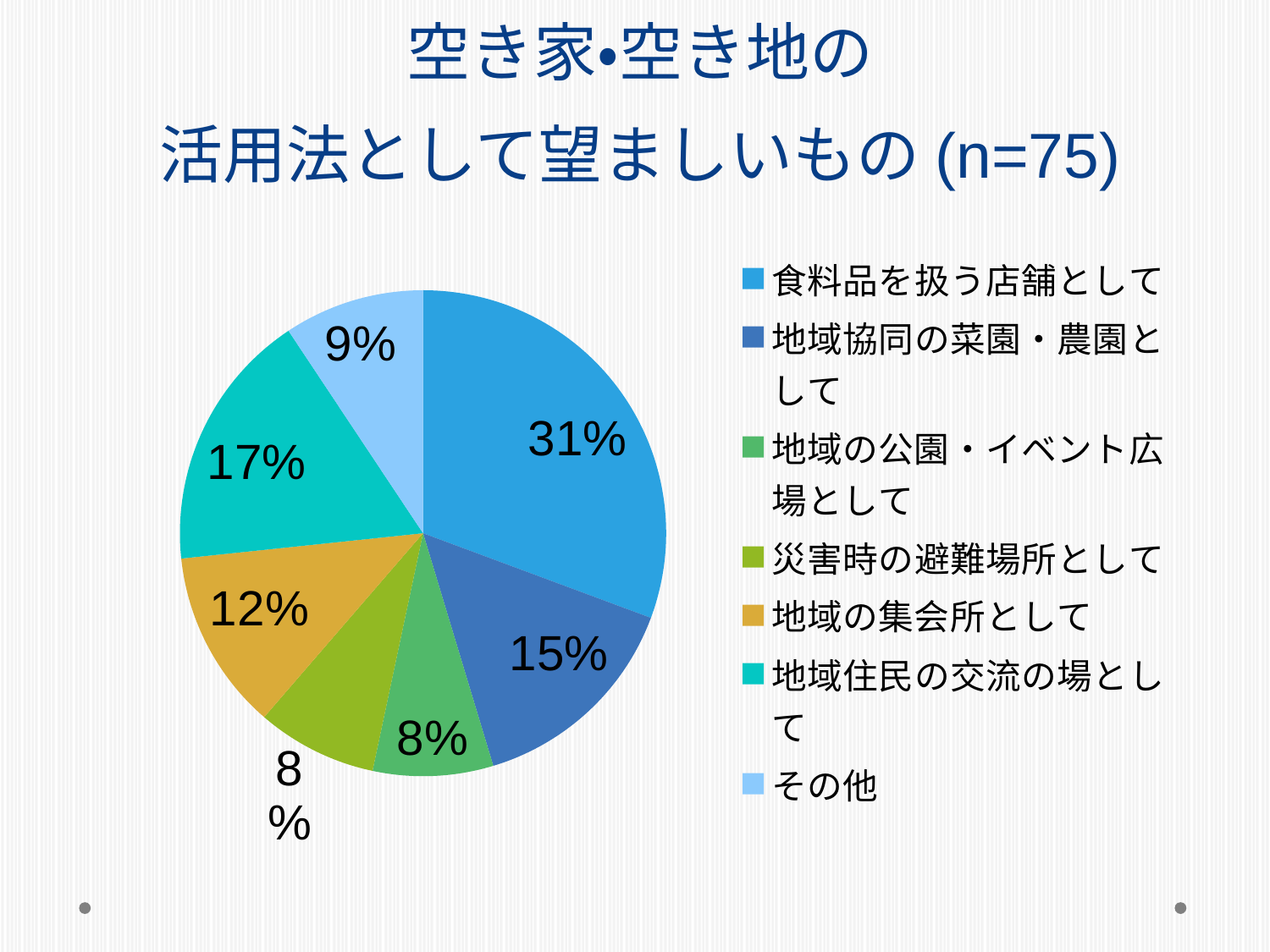
What share of the pie is 地域住民の交流の場として? 17% How many categories does the legend list? 7 What share of the pie is 地域協同の菜園・農園として? 15% What is the sample size (n) stated in the chart title? 75 What share of the pie is 地域の集会所として? 12% What kind of chart is shown on the slide? pie chart Which is larger, the share for 地域住民の交流の場として or the share for 地域の集会所として? 地域住民の交流の場として Which category has the largest share of the pie? 食料品を扱う店舗として What colour is the slice for その他? light blue What is the difference in percentage points between 食料品を扱う店舗として and 地域協同の菜園・農園として? 16